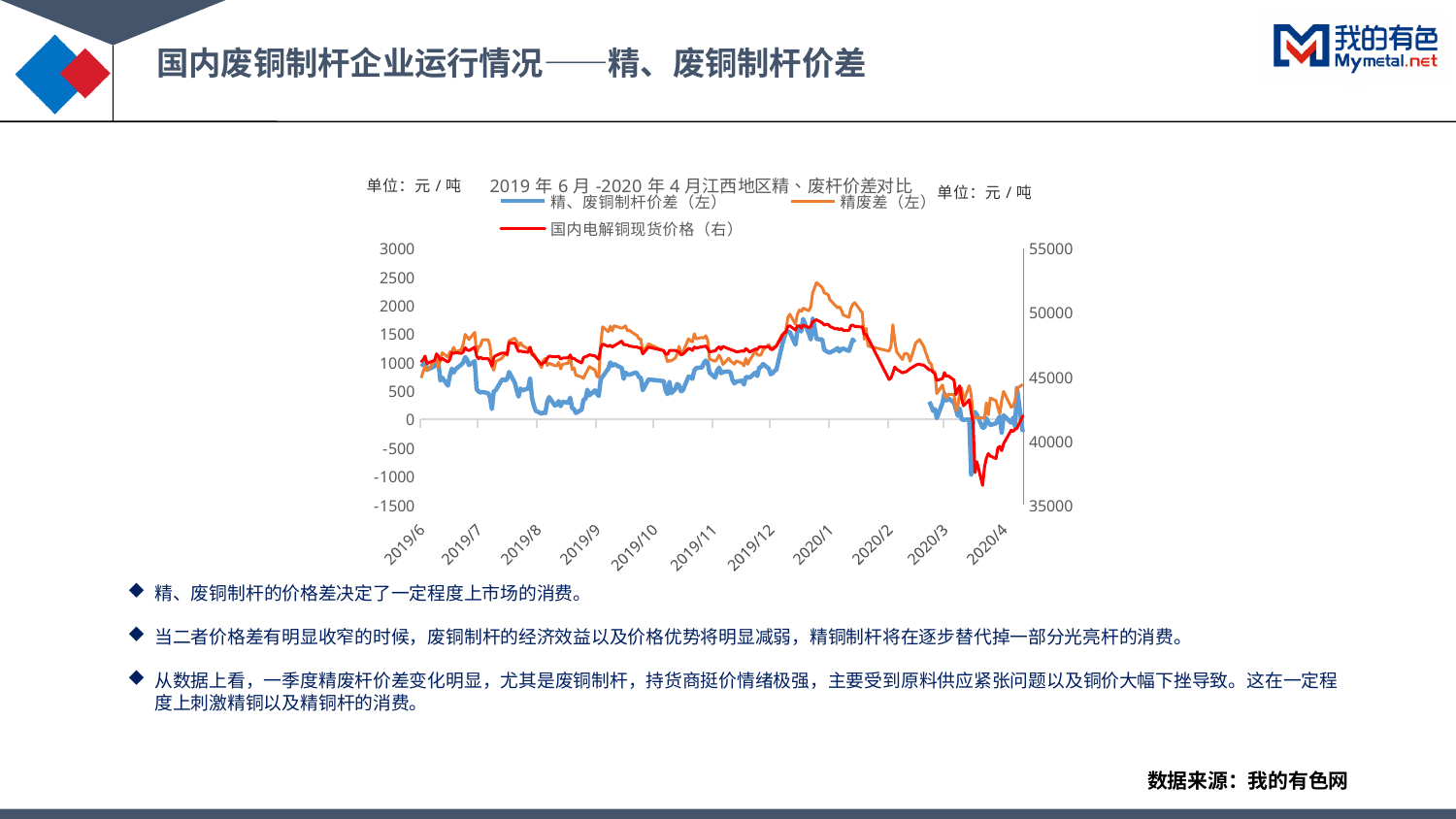
Does the 国内电解铜现货价格（右） series rise or fall between 2020/1 and 2020/3? fall Which series is plotted against the right-hand axis according to the legend? 国内电解铜现货价格（右） Is the value of the 国内电解铜现货价格（右） series at its lowest point around 2020/3 greater or less than 40000? less Is the value of the 精、废铜制杆价差（左） series around 2019/8 greater or less than 500? less Is the peak value of the 精废差（左） series around 2020/1 greater or less than 2000? greater How many series does the legend list? 3 What is the title of the chart? 2019年6月-2020年4月江西地区精、废杆价差对比 Which of the two left-axis series reaches the higher peak around 2020/1, 精废差（左） or 精、废铜制杆价差（左）? 精废差（左） Does the 精、废铜制杆价差（左） series generally rise or fall between 2019/8 and 2020/1? rise What kind of chart is shown on the slide? line chart How many month labels are shown on the x axis? 11